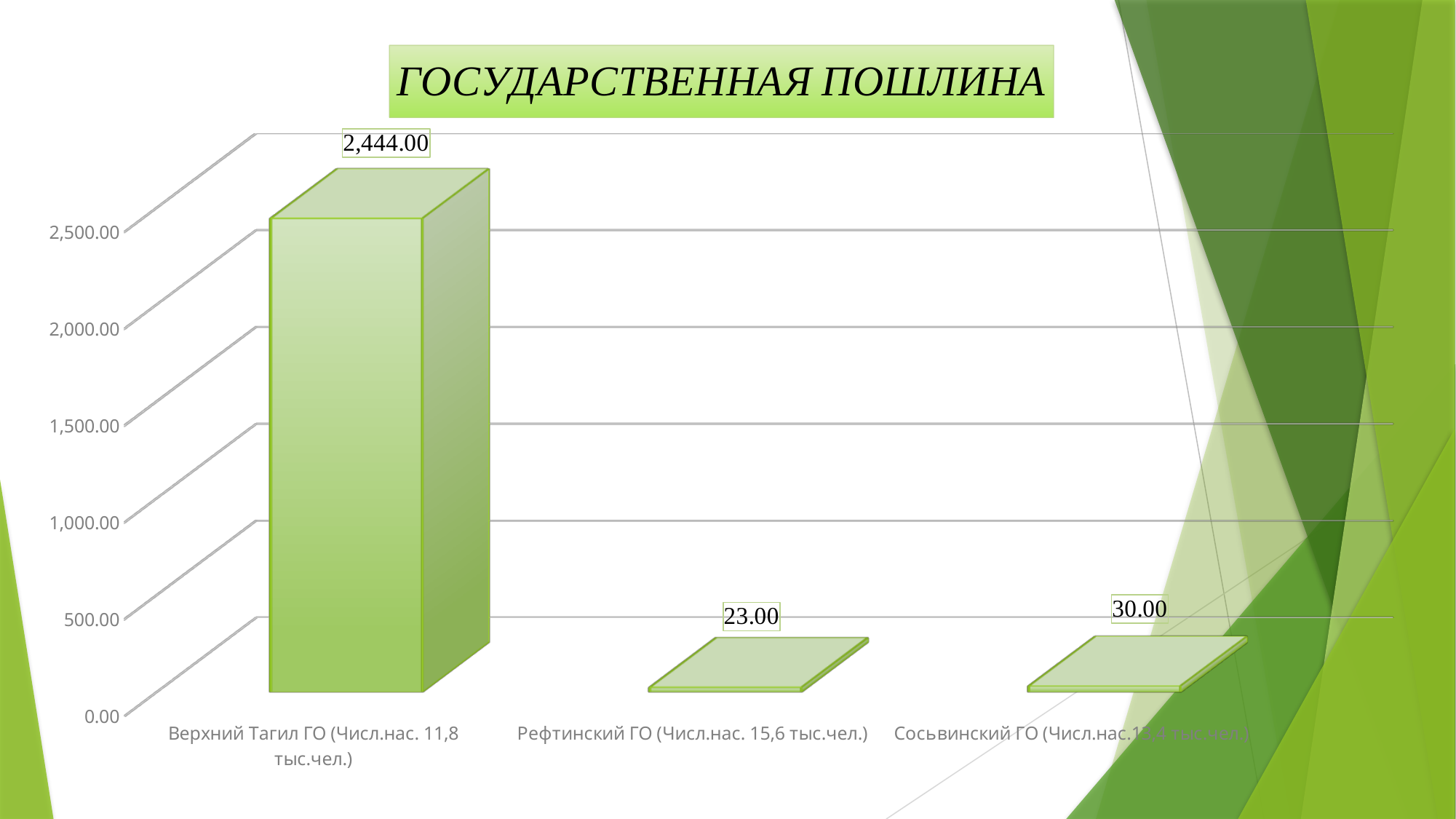
What is the title of the chart? ГОСУДАРСТВЕННАЯ ПОШЛИНА What is the difference between the values for Сосьвинский ГО and Рефтинский ГО? 7.00 How many categories are shown on the chart? 3 Which category has the highest value? Верхний Тагил ГО What is the value for Верхний Тагил ГО? 2,444.00 Is the value for Верхний Тагил ГО greater or less than 2,000.00? greater Which category has the lowest value? Рефтинский ГО What kind of chart is shown on the slide? bar chart What is the value for Рефтинский ГО? 23.00 What is the difference between the values for Верхний Тагил ГО and Сосьвинский ГО? 2,414.00 Which is larger, the value for Рефтинский ГО or the value for Сосьвинский ГО? Сосьвинский ГО What is the value for Сосьвинский ГО? 30.00